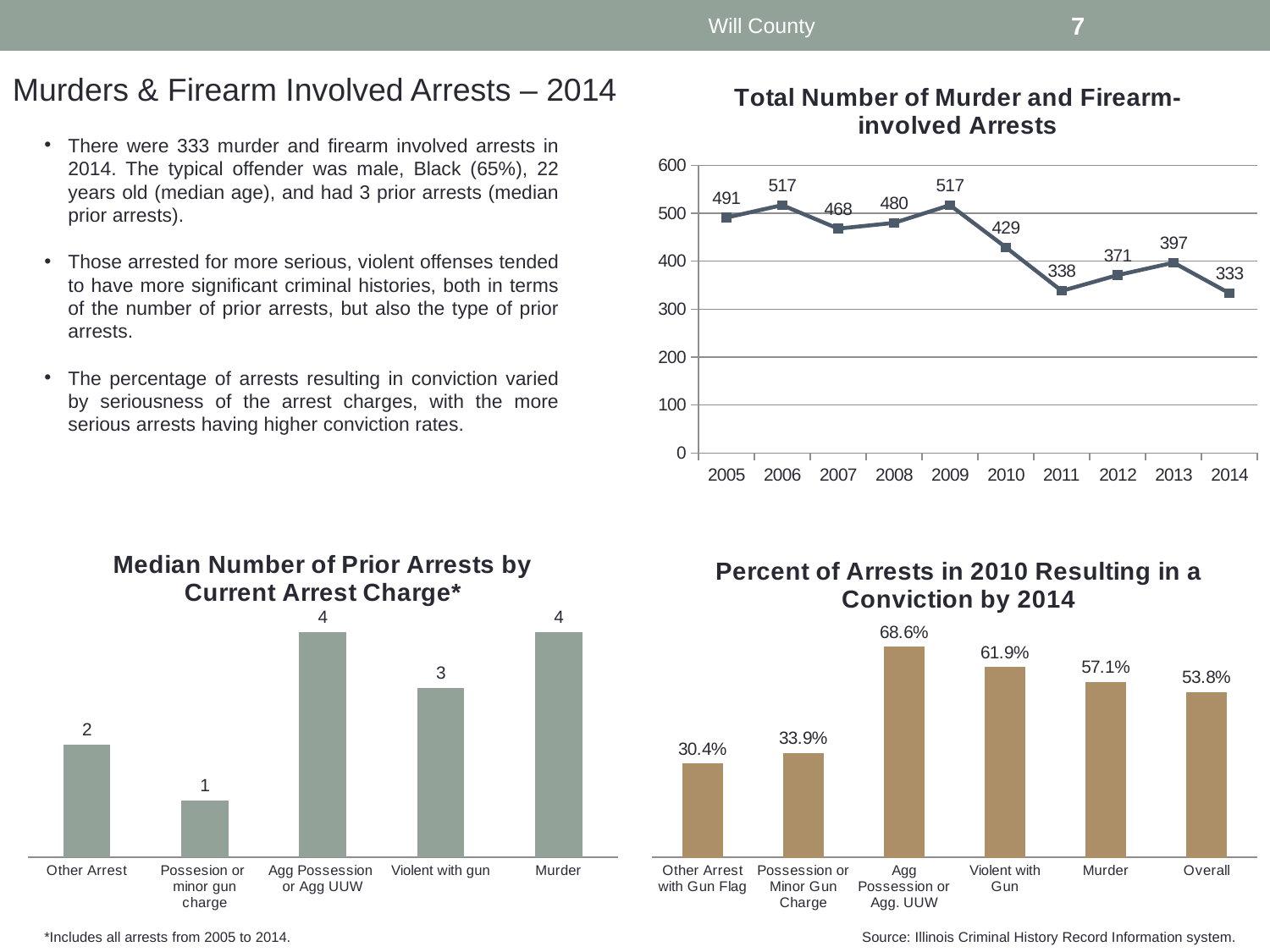
In the 'Total Number of Murder and Firearm-involved Arrests' chart, which year has the lowest value? 2014 In the 'Percent of Arrests in 2010 Resulting in a Conviction by 2014' chart, which category has the highest value? Agg Possession or Agg. UUW In the 'Total Number of Murder and Firearm-involved Arrests' chart, what is the value for 2009? 517 In the 'Median Number of Prior Arrests by Current Arrest Charge*' chart, what is the value for Violent with gun? 3 In the 'Total Number of Murder and Firearm-involved Arrests' chart, do the values generally rise or fall from 2009 to 2011? Fall In the 'Percent of Arrests in 2010 Resulting in a Conviction by 2014' chart, what is the value for Murder? 57.1% What kind of chart is 'Median Number of Prior Arrests by Current Arrest Charge*'? Bar chart In the 'Total Number of Murder and Firearm-involved Arrests' chart, what is the difference between the 2005 value and the 2014 value? 158 In the 'Total Number of Murder and Firearm-involved Arrests' chart, how many years are plotted? 10 In the 'Median Number of Prior Arrests by Current Arrest Charge*' chart, which category has the lowest value? Possesion or minor gun charge What kind of chart is 'Total Number of Murder and Firearm-involved Arrests'? Line chart In the 'Percent of Arrests in 2010 Resulting in a Conviction by 2014' chart, which is larger: Violent with Gun or Overall? Violent with Gun